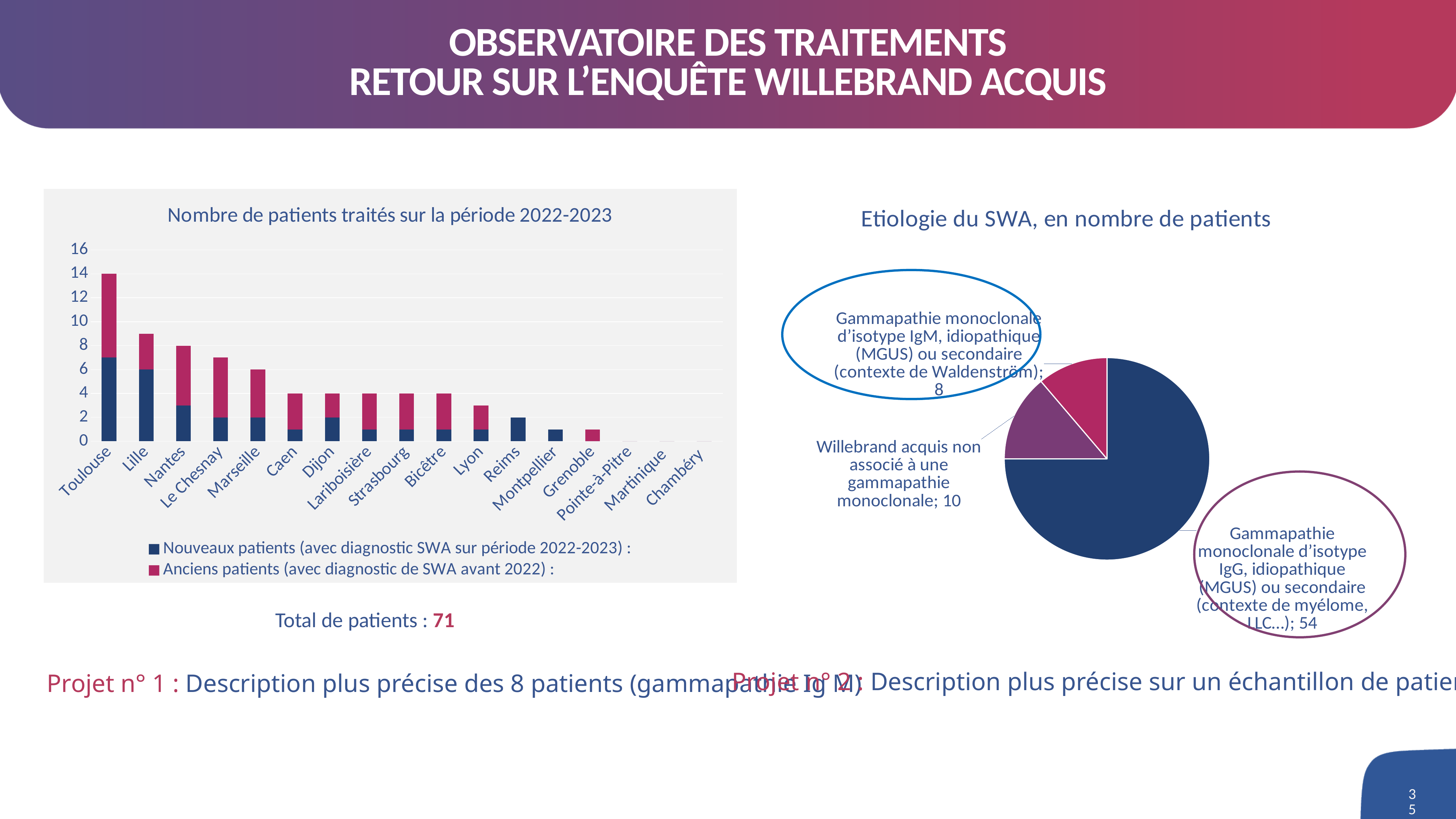
In the chart 'Nombre de patients traités sur la période 2022-2023', what is the total number of patients for Toulouse? 14 In the pie chart 'Etiologie du SWA, en nombre de patients', which etiology has the smallest number of patients? Gammapathie monoclonale d'isotype IgM In the chart 'Nombre de patients traités sur la période 2022-2023', which centre has the highest total number of patients? Toulouse What kind of chart is 'Etiologie du SWA, en nombre de patients'? pie chart In the pie chart 'Etiologie du SWA, en nombre de patients', what is the difference between the IgG gammapathie count and the IgM gammapathie count? 46 What kind of chart is 'Nombre de patients traités sur la période 2022-2023'? bar chart In the chart 'Nombre de patients traités sur la période 2022-2023', how many series does the legend list? 2 In the pie chart 'Etiologie du SWA, en nombre de patients', how many patients have Willebrand acquis non associé à une gammapathie monoclonale? 10 In the chart 'Nombre de patients traités sur la période 2022-2023', do the total bar heights rise or fall from left to right along the x axis? fall In the chart 'Nombre de patients traités sur la période 2022-2023', is the total for Lille greater or less than 10? less In the chart 'Nombre de patients traités sur la période 2022-2023', how many centres are shown on the x axis? 17 In the chart 'Nombre de patients traités sur la période 2022-2023', what is the total number of patients for Marseille? 6